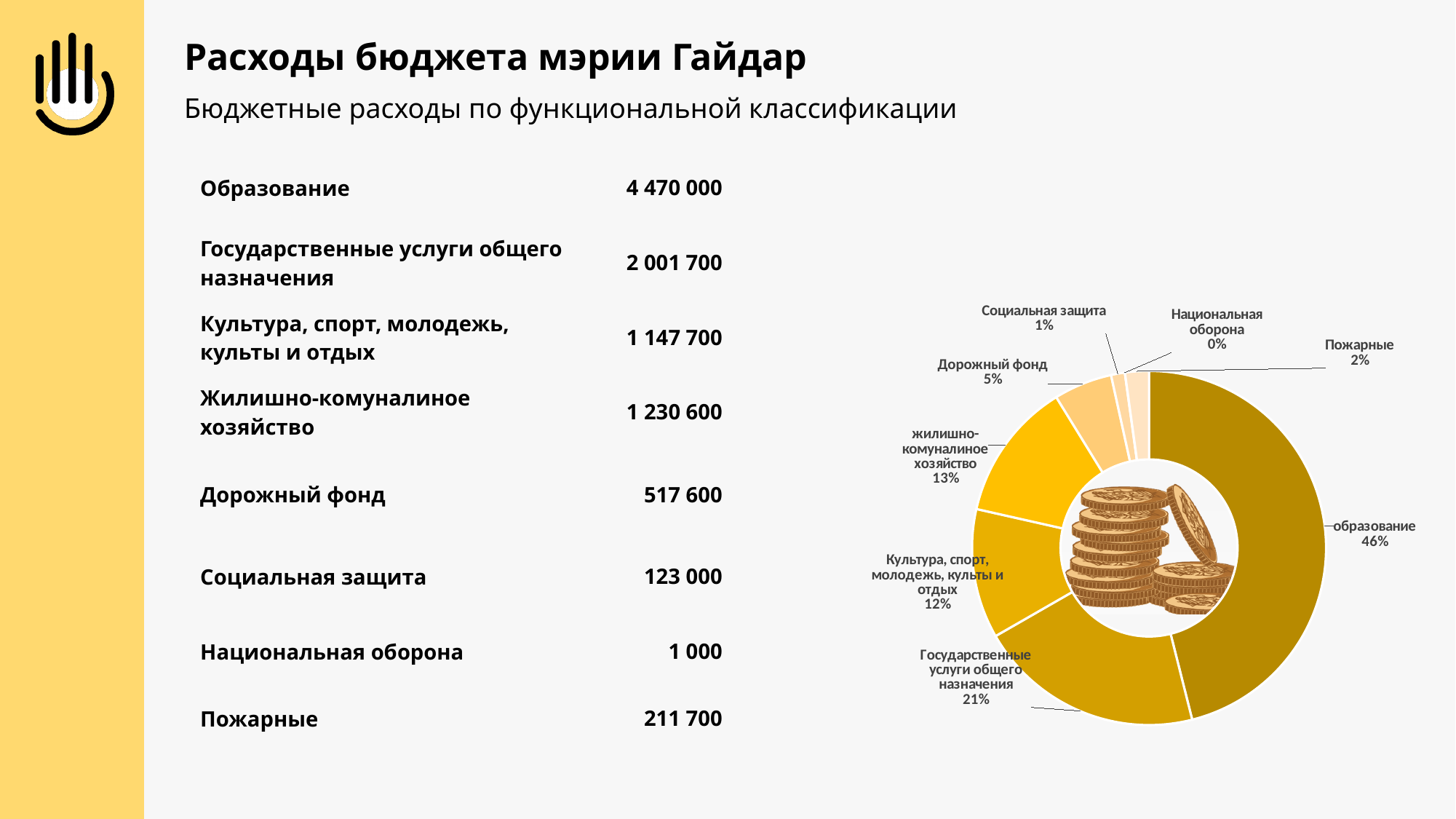
What share of the doughnut chart does Дорожный фонд take? 5% What share of the doughnut chart does Государственные услуги общего назначения take? 21% What share of the doughnut chart does жилишно-комуналиное хозяйство take? 13% What kind of chart is shown on the slide? Doughnut (pie) chart Which slice is larger in the doughnut chart: жилишно-комуналиное хозяйство or Дорожный фонд? жилишно-комуналиное хозяйство Which category has the largest slice in the doughnut chart? образование How many categories are shown in the doughnut chart? 8 What is the title of the slide containing the doughnut chart? Расходы бюджета мэрии Гайдар Which category has the smallest slice in the doughnut chart? Национальная оборона What is the difference in percentage points between the образование slice and the Государственные услуги общего назначения slice? 25%